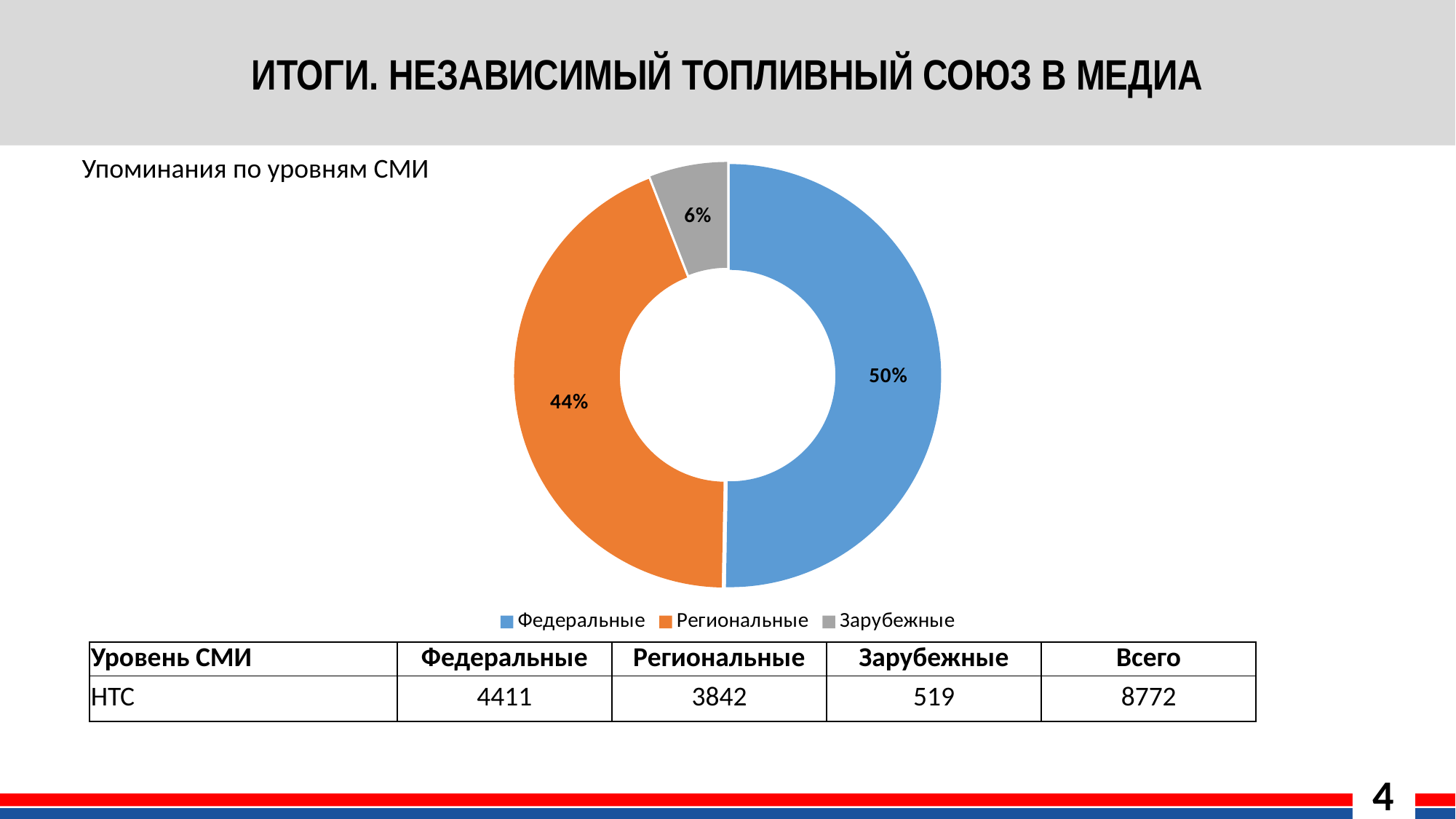
What share of the doughnut chart does the Региональные slice represent? 44% Which category has the largest slice in the doughnut chart? Федеральные What is the difference in percentage points between the Федеральные and Региональные slices? 6% What type of chart is shown on the slide? Doughnut chart What share of the doughnut chart does the Федеральные slice represent? 50% Which slice is larger, Региональные or Зарубежные? Региональные What is the title of the chart on the slide? Упоминания по уровням СМИ How many categories are shown in the doughnut chart? 3 What share of the doughnut chart does the Зарубежные slice represent? 6% What colour is the Региональные slice in the doughnut chart? Orange Which category has the smallest slice in the doughnut chart? Зарубежные How many entries does the legend of the chart list? 3